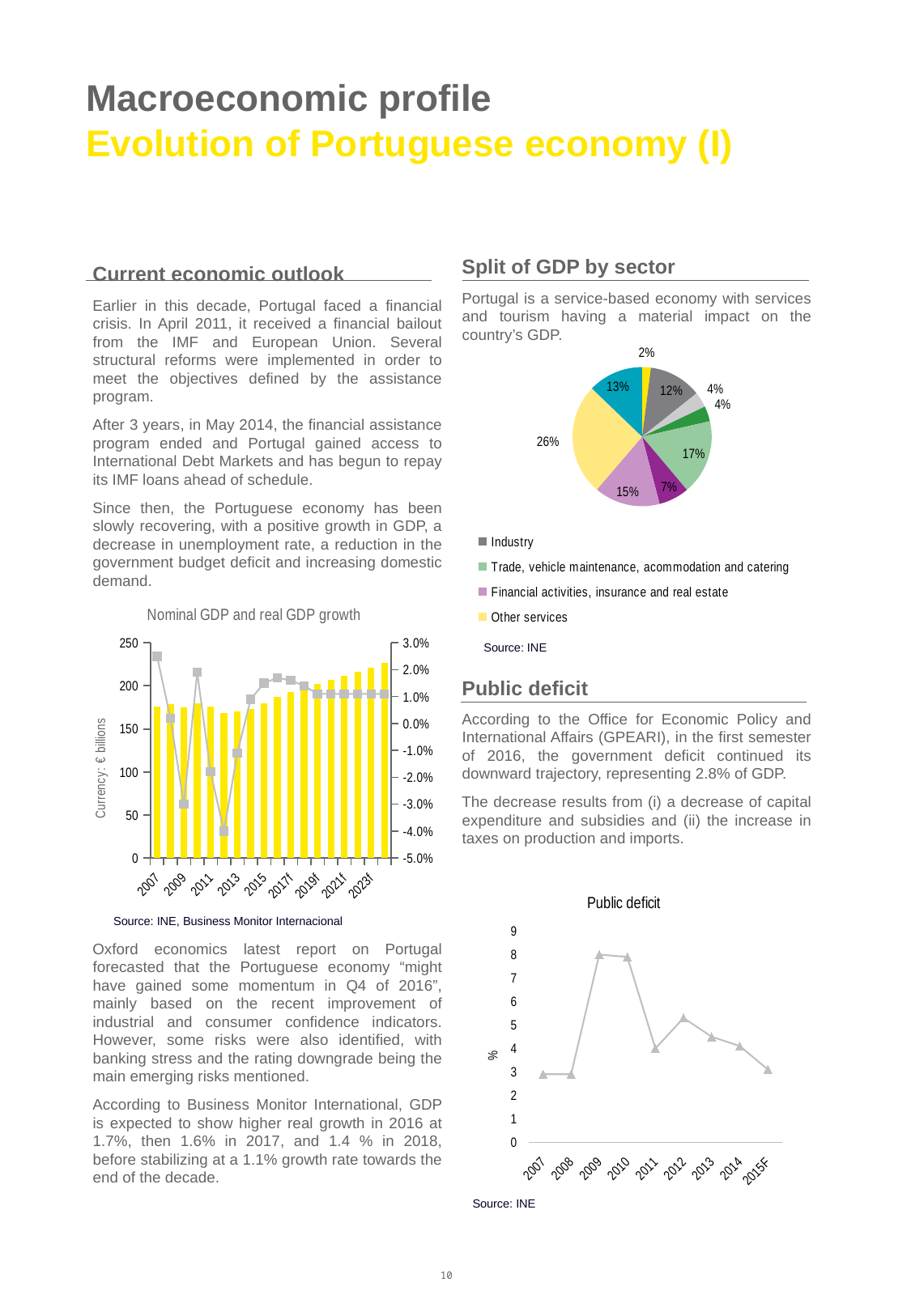
In the 'Split of GDP by sector' pie chart, what is the share of the largest slice? 26% What kind of chart is the 'Public deficit' chart? Line chart In the 'Split of GDP by sector' pie chart, what is the share of the smallest slice? 2% In the 'Split of GDP by sector' pie chart, which legend entry is shown in yellow? Other services In the 'Nominal GDP and real GDP growth' chart, is the nominal GDP bar for 2023f greater or less than 200? greater In the 'Public deficit' chart, is the value for 2015F greater or less than 4? less How many slices does the 'Split of GDP by sector' pie chart have? 9 In the 'Public deficit' chart, do the values rise or fall from 2012 to 2015F? fall How many data points are plotted in the 'Public deficit' chart? 9 In the 'Split of GDP by sector' pie chart, what is the difference between the 17% slice and the 7% slice? 10% How many entries does the legend of the 'Split of GDP by sector' pie chart list? 4 In the 'Public deficit' chart, is the value for 2009 greater or less than 7? greater